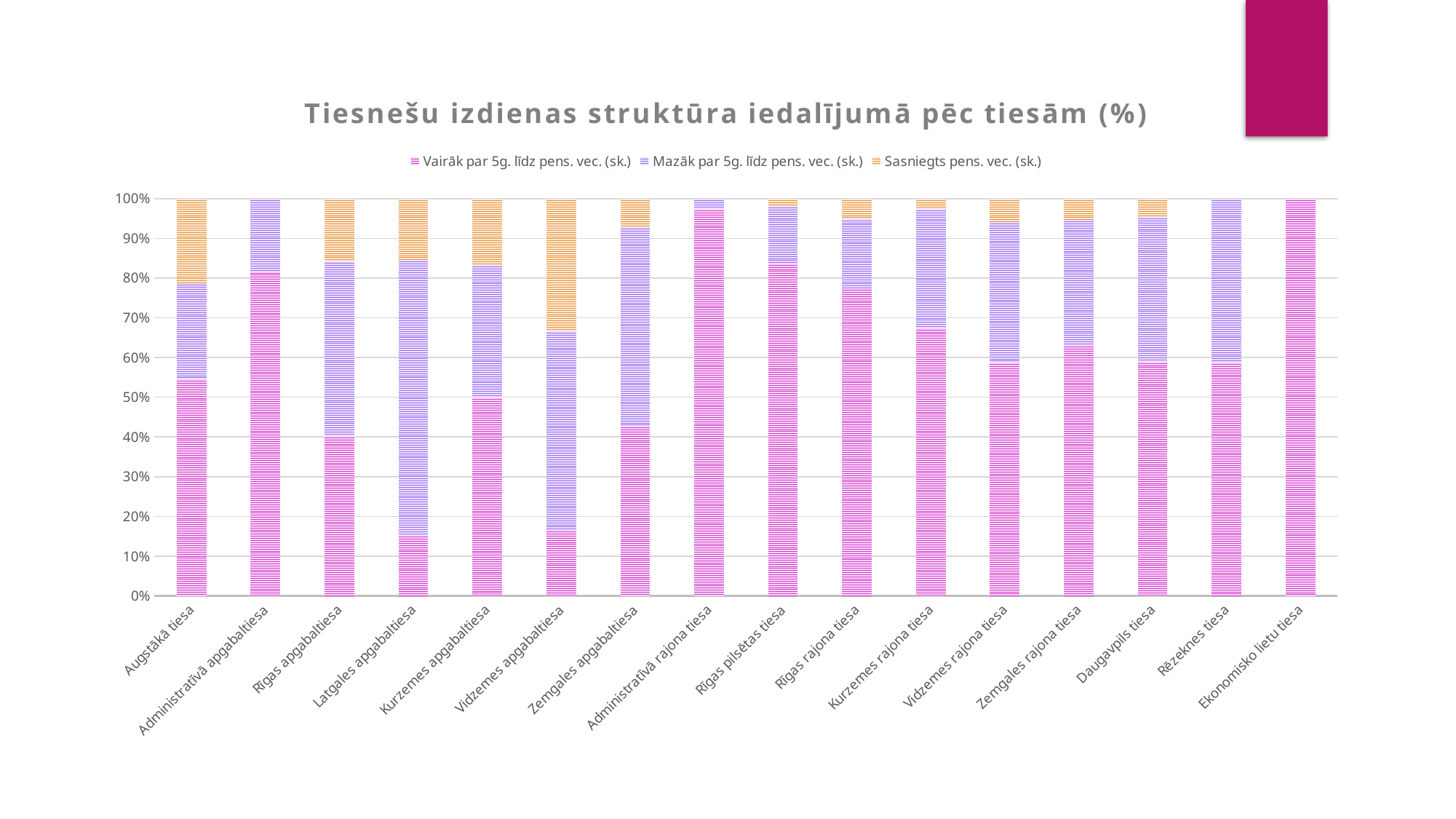
What kind of chart is shown on the slide? bar chart Is the 'Vairāk par 5g. līdz pens. vec. (sk.)' share for Augstākā tiesa greater or less than 50%? greater What is the title of the chart? Tiesnešu izdienas struktūra iedalījumā pēc tiesām (%) Is the 'Vairāk par 5g. līdz pens. vec. (sk.)' share for Kurzemes rajona tiesa greater or less than 60%? greater Which court has the highest share for 'Vairāk par 5g. līdz pens. vec. (sk.)'? Ekonomisko lietu tiesa How many series does the legend list? 3 Is the 'Sasniegts pens. vec. (sk.)' share for Vidzemes apgabaltiesa greater or less than 30%? greater Which court has the highest share for 'Sasniegts pens. vec. (sk.)'? Vidzemes apgabaltiesa How many courts (categories) are shown on the x axis? 16 Which series is listed first in the legend? Vairāk par 5g. līdz pens. vec. (sk.) Which has the larger 'Sasniegts pens. vec. (sk.)' share, Vidzemes apgabaltiesa or Augstākā tiesa? Vidzemes apgabaltiesa Which has the larger 'Vairāk par 5g. līdz pens. vec. (sk.)' share, Augstākā tiesa or Rīgas apgabaltiesa? Augstākā tiesa